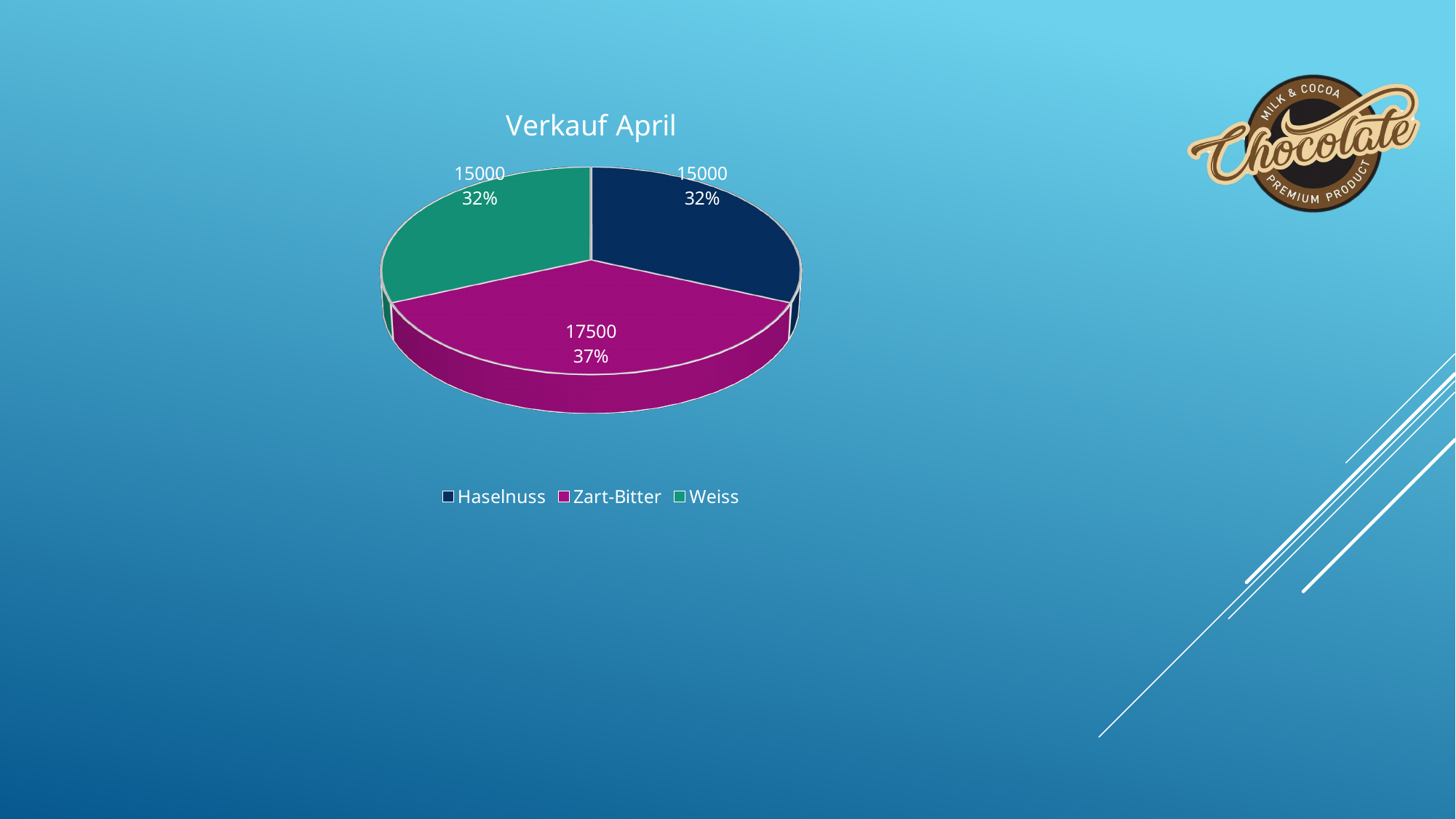
How many categories are shown in the pie chart? 3 What share of the pie does Weiss represent? 32% Which category has the highest value? Zart-Bitter What share of the pie does Zart-Bitter represent? 37% Which is larger, the value for Zart-Bitter or the value for Weiss? Zart-Bitter What kind of chart is shown on the slide? Pie chart What is the value for Weiss? 15000 Which category is shown in magenta? Zart-Bitter What is the title of the chart? Verkauf April What is the difference between the values for Zart-Bitter and Haselnuss? 2500 What is the value for Haselnuss? 15000 What is the value for Zart-Bitter? 17500